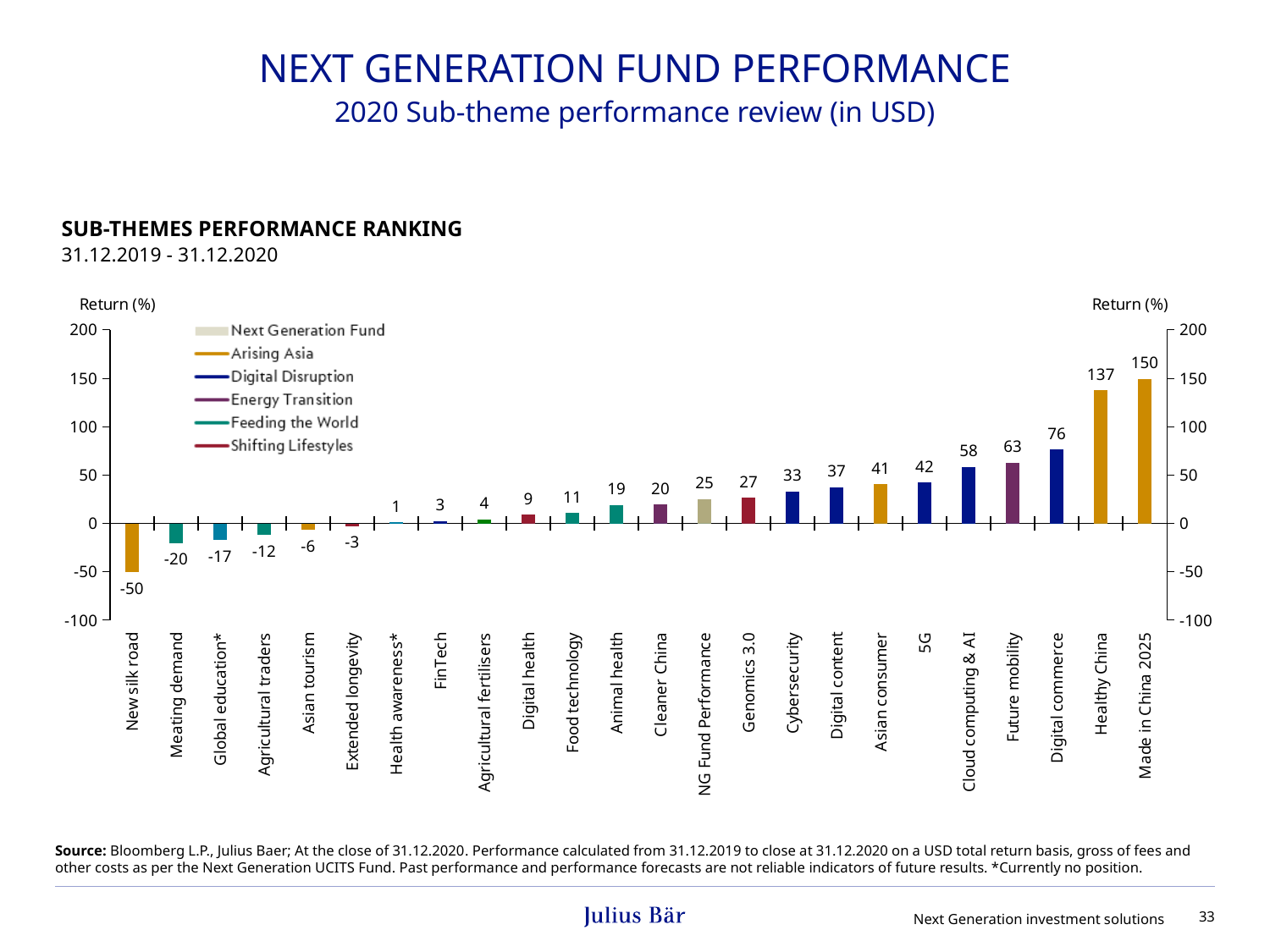
What kind of chart is shown on the slide? Bar chart What is the difference in return (%) between Healthy China and Digital commerce? 61 What is the return (%) shown for Cloud computing & AI? 58 What is the return (%) shown for New silk road? -50 Which sub-theme has the lowest return? New silk road Do the values rise or fall moving from left to right along the x axis? Rise Which has a higher return, Future mobility or 5G? Future mobility What is the return (%) shown for Made in China 2025? 150 Which sub-theme has the highest return? Made in China 2025 How many series does the legend list? 6 What is the return (%) shown for NG Fund Performance? 25 How many sub-theme bars are plotted on the chart? 24